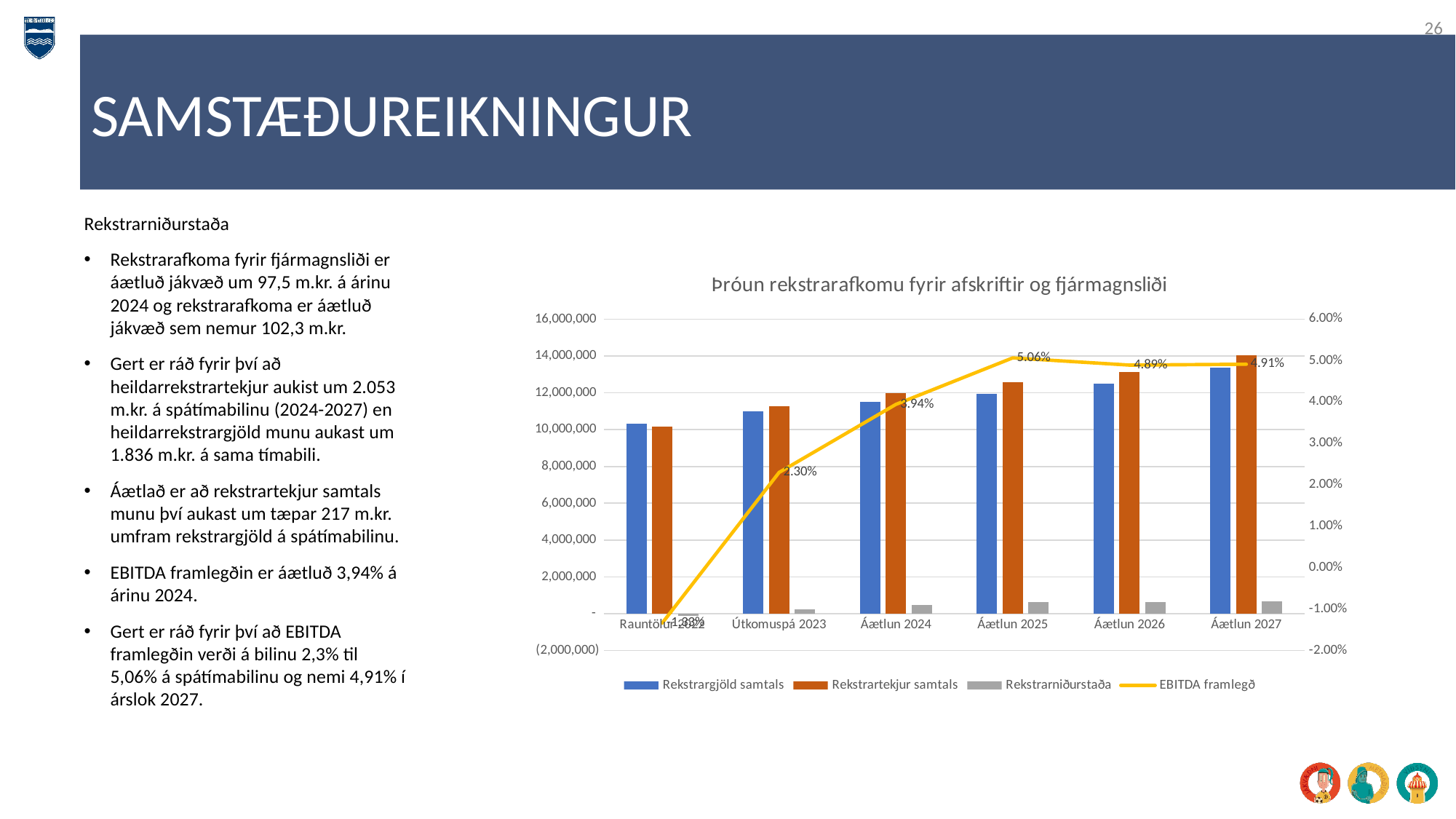
What is the title of the chart? Þróun rekstrarafkomu fyrir afskriftir og fjármagnsliði What is the EBITDA framlegð value for Áætlun 2024? 3.94% How many categories are shown along the x axis of the chart? 6 What is the EBITDA framlegð value for Áætlun 2027? 4.91% What is the EBITDA framlegð value for Áætlun 2025? 5.06% Is the value of Rekstrartekjur samtals for Áætlun 2027 greater or less than 12,000,000? greater What is the difference between the EBITDA framlegð for Áætlun 2025 and Áætlun 2024? 1.12 percentage points In which category is the EBITDA framlegð highest? Áætlun 2025 How many series does the chart legend list? 4 In Áætlun 2027, which is larger: Rekstrartekjur samtals or Rekstrargjöld samtals? Rekstrartekjur samtals What is the EBITDA framlegð value for Útkomuspá 2023? 2.30% What kind of chart is shown on the slide? A bar chart combined with a line